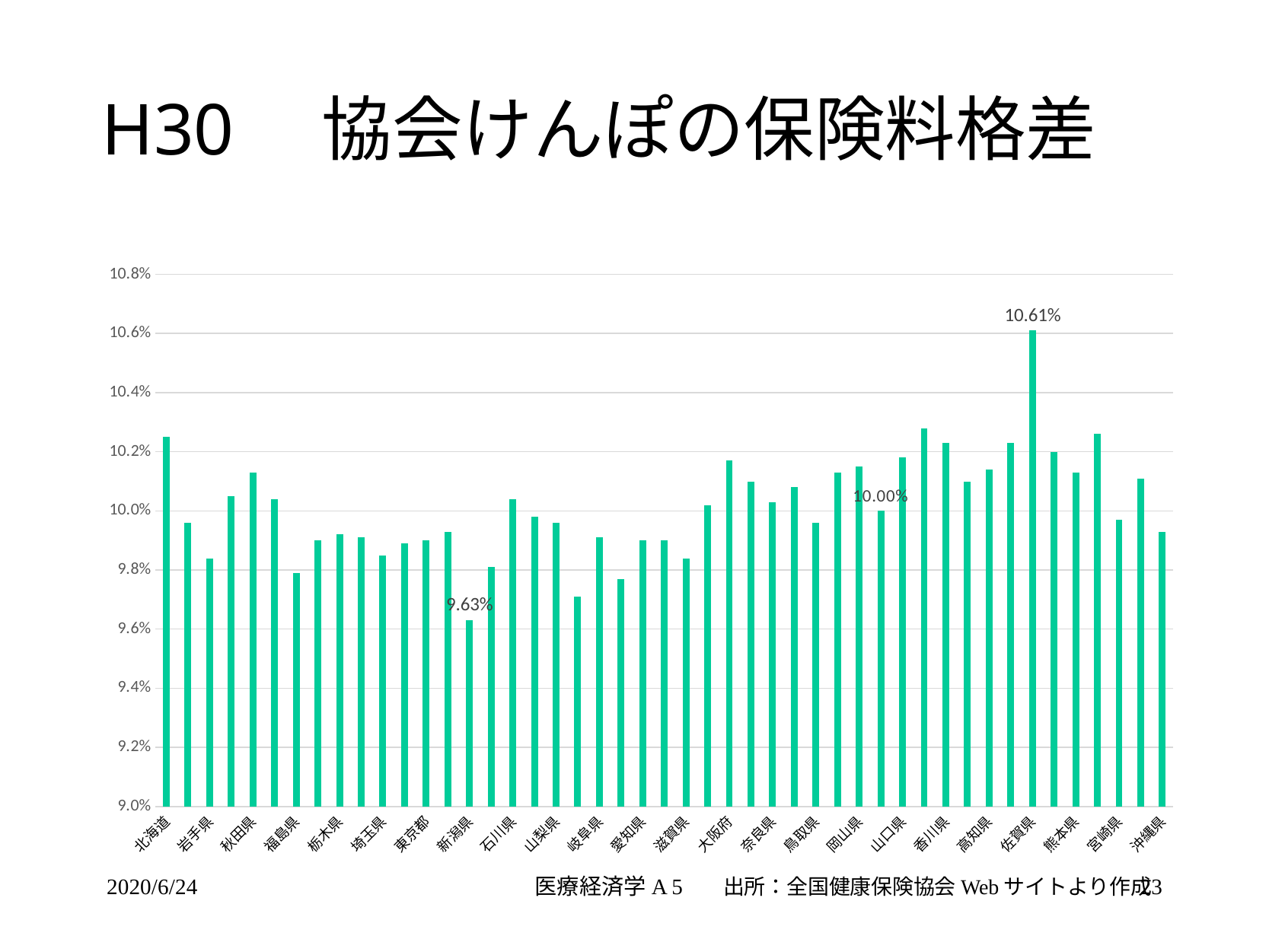
What is the title of the slide? H30 協会けんぽの保険料格差 What is the value shown for 佐賀県? 10.61% Which has the larger value, 北海道 or 岩手県? 北海道 Which prefecture has the highest value in the chart? 佐賀県 What is the value shown for 新潟県? 9.63% What kind of chart is shown on the slide? bar chart Which prefecture has the lowest value in the chart? 新潟県 Is the value for 岐阜県 greater or less than 9.8%? greater What is the difference between the values for 佐賀県 and 新潟県? 0.98% Is the value for 北海道 greater or less than 10.0%? greater